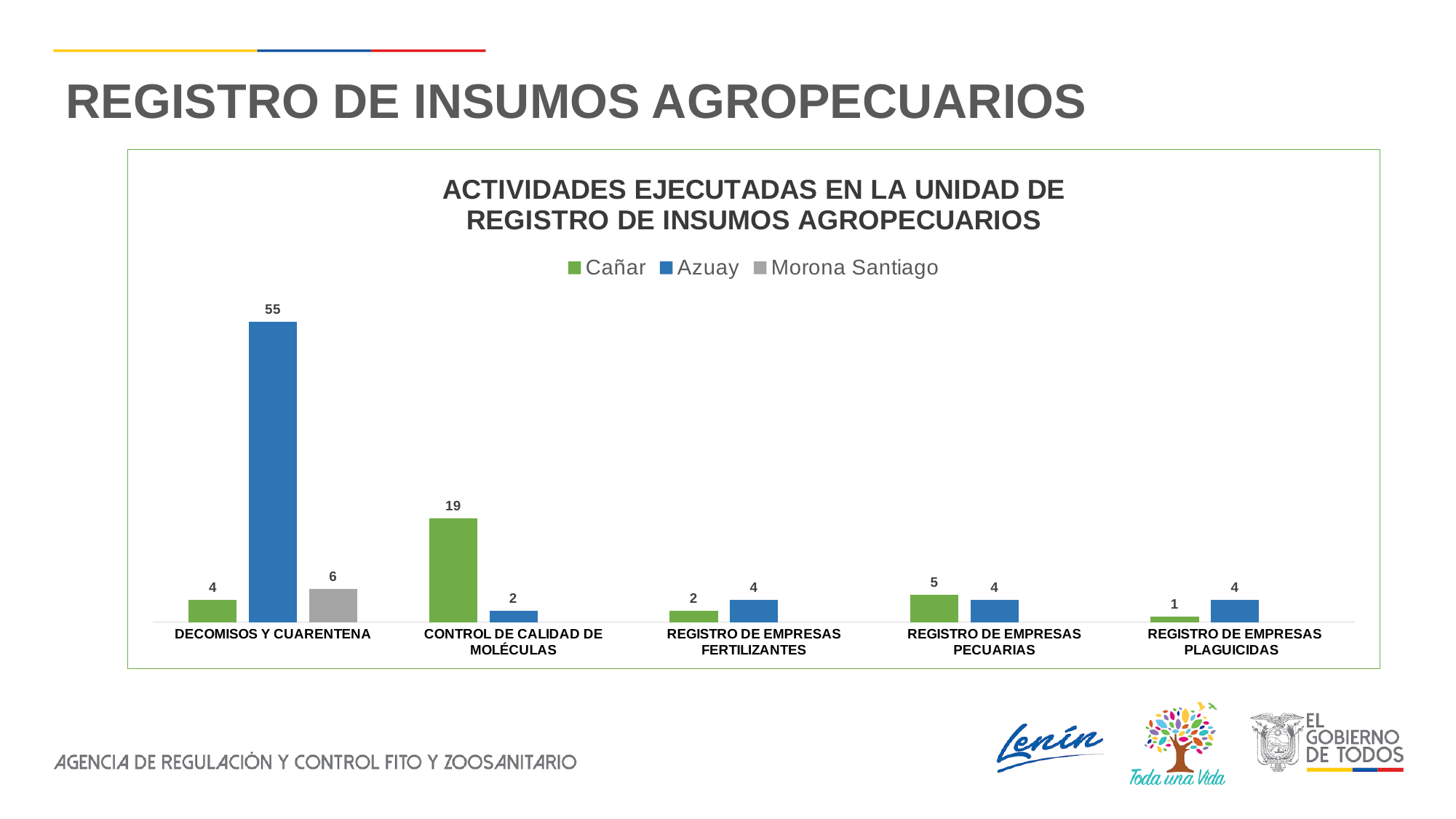
What kind of chart is shown on the slide? Bar chart Which colour represents Azuay in the chart? Blue How many categories are shown on the x axis? 5 What is the difference between the Azuay and Cañar values in the DECOMISOS Y CUARENTENA category? 51 In the CONTROL DE CALIDAD DE MOLÉCULAS category, which is larger, Cañar or Azuay? Cañar Which category has the highest value for Azuay? DECOMISOS Y CUARENTENA How many series does the legend list? 3 What is the value for Azuay in the DECOMISOS Y CUARENTENA category? 55 What is the value for Morona Santiago in the DECOMISOS Y CUARENTENA category? 6 What is the value for Cañar in the CONTROL DE CALIDAD DE MOLÉCULAS category? 19 Which category has the lowest value for Cañar? REGISTRO DE EMPRESAS PLAGUICIDAS What is the value for Cañar in the REGISTRO DE EMPRESAS PLAGUICIDAS category? 1